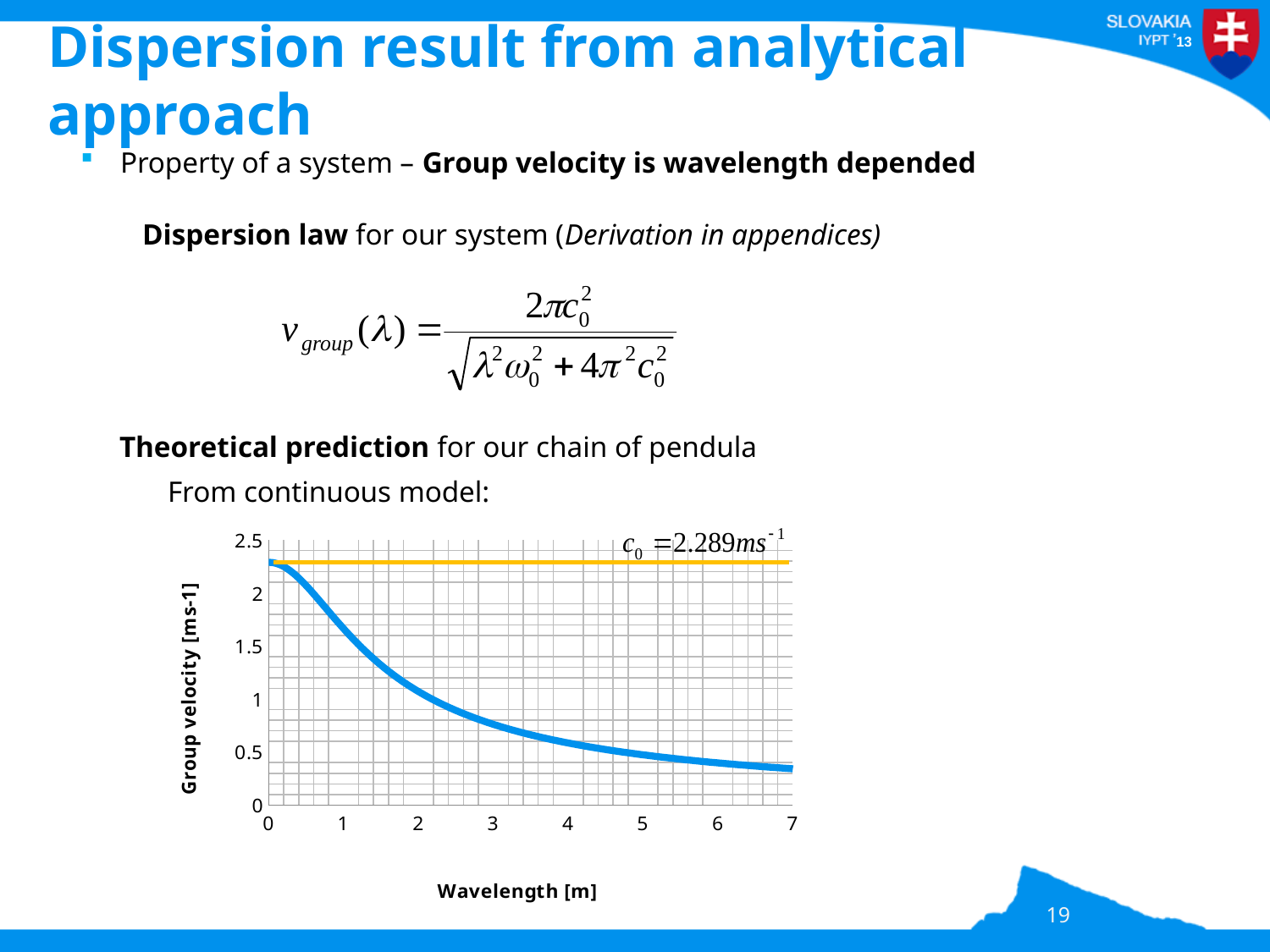
Is the group velocity at a wavelength of 1 m greater or less than 1? greater What is the highest wavelength value shown on the x axis? 7 Is the group velocity at a wavelength of 4 m greater or less than 1? less Is the blue group velocity curve above or below the yellow c0 line? below What is the label of the x axis of the chart? Wavelength [m] Is the group velocity at a wavelength of 6 m greater or less than 0.5? less What kind of chart is shown on the slide? line chart What is the label of the y axis of the chart? Group velocity [ms-1] Which is larger: the group velocity at a wavelength of 1 m or at a wavelength of 5 m? 1 m What value of c0 is printed next to the horizontal yellow line on the chart? 2.289 ms^-1 Does the group velocity rise or fall as wavelength increases along the x axis? fall